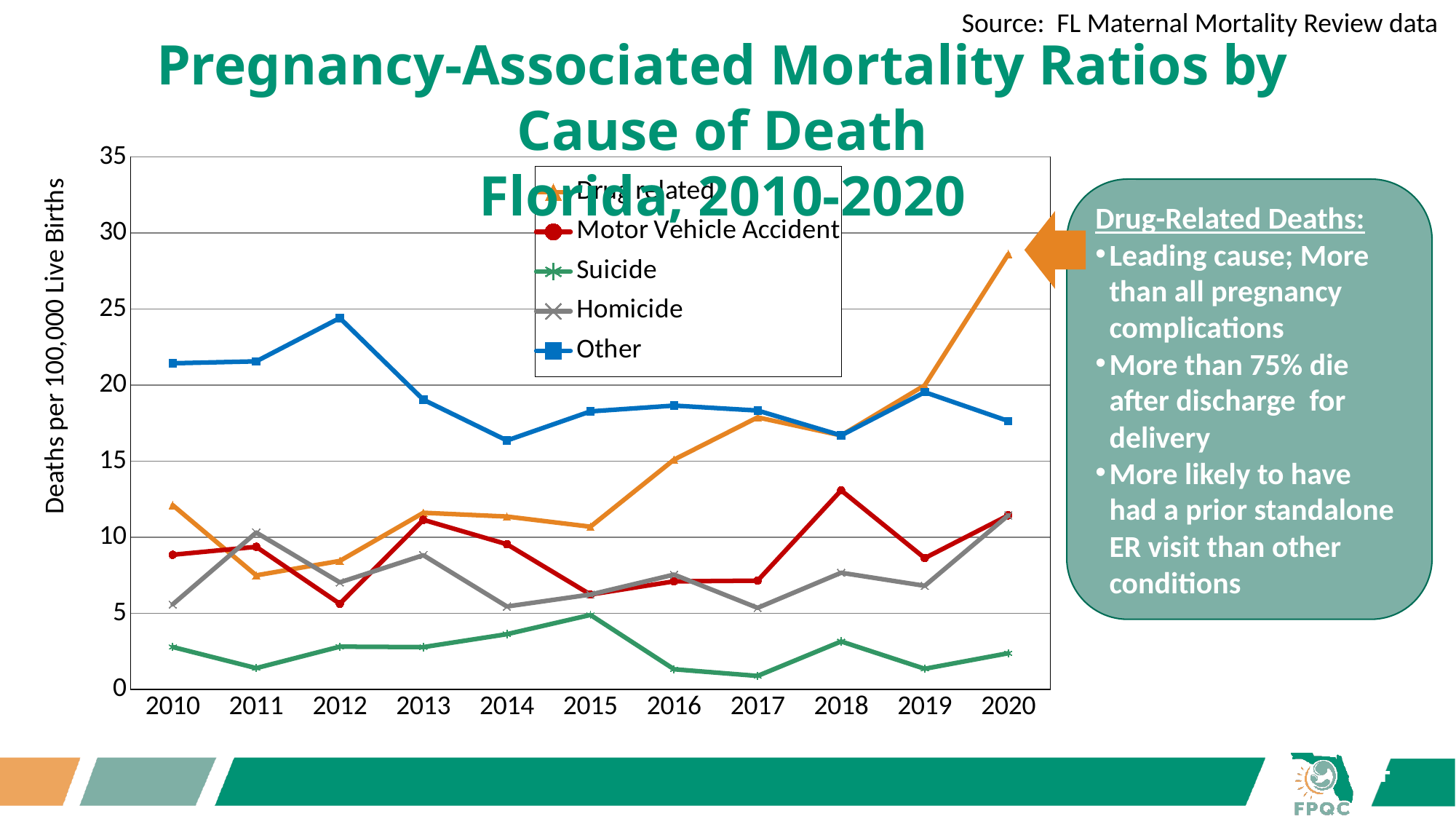
Does the Drug related series rise or fall from 2015 to 2020? rise In which year does the Other series reach its highest value? 2012 Which cause of death has the lowest value in 2020? Suicide Which cause of death has the highest value in 2020? Drug related How many series does the legend list? 5 How many years are plotted along the x axis? 11 In 2018, which is larger: Motor Vehicle Accident or Homicide? Motor Vehicle Accident What is the label on the y axis? Deaths per 100,000 Live Births Is the value for Other in 2012 greater or less than 20? greater What kind of chart is shown on the slide? line chart Is the value for Drug related in 2020 greater or less than 25? greater Is the value for Suicide in 2017 greater or less than 5? less